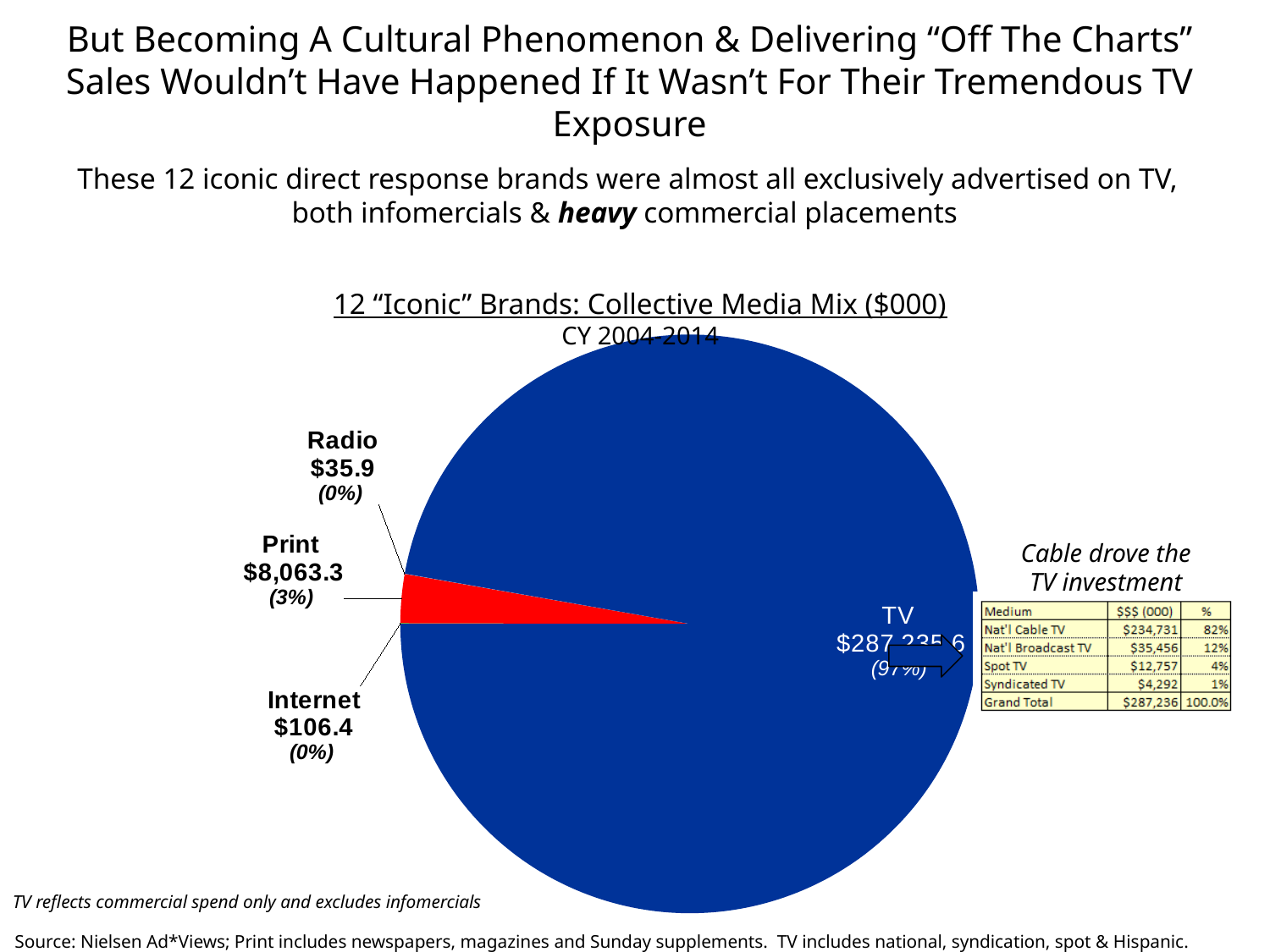
Which medium has the smallest value in the pie chart? Radio What colour is the Print slice in the pie chart? Red What type of chart is shown on the slide? Pie chart Which is larger, the value for Internet or the value for Radio? Internet Which medium has the largest slice of the pie chart? TV How many media categories are shown in the pie chart? 4 What is the value for Print in the pie chart? $8,063.3 What is the difference between the Print and Internet values? $7,956.9 What is the value for Internet in the pie chart? $106.4 What is the difference between the Internet and Radio values? $70.5 What is the value for Radio in the pie chart? $35.9 What share of the pie does Print represent? 3%